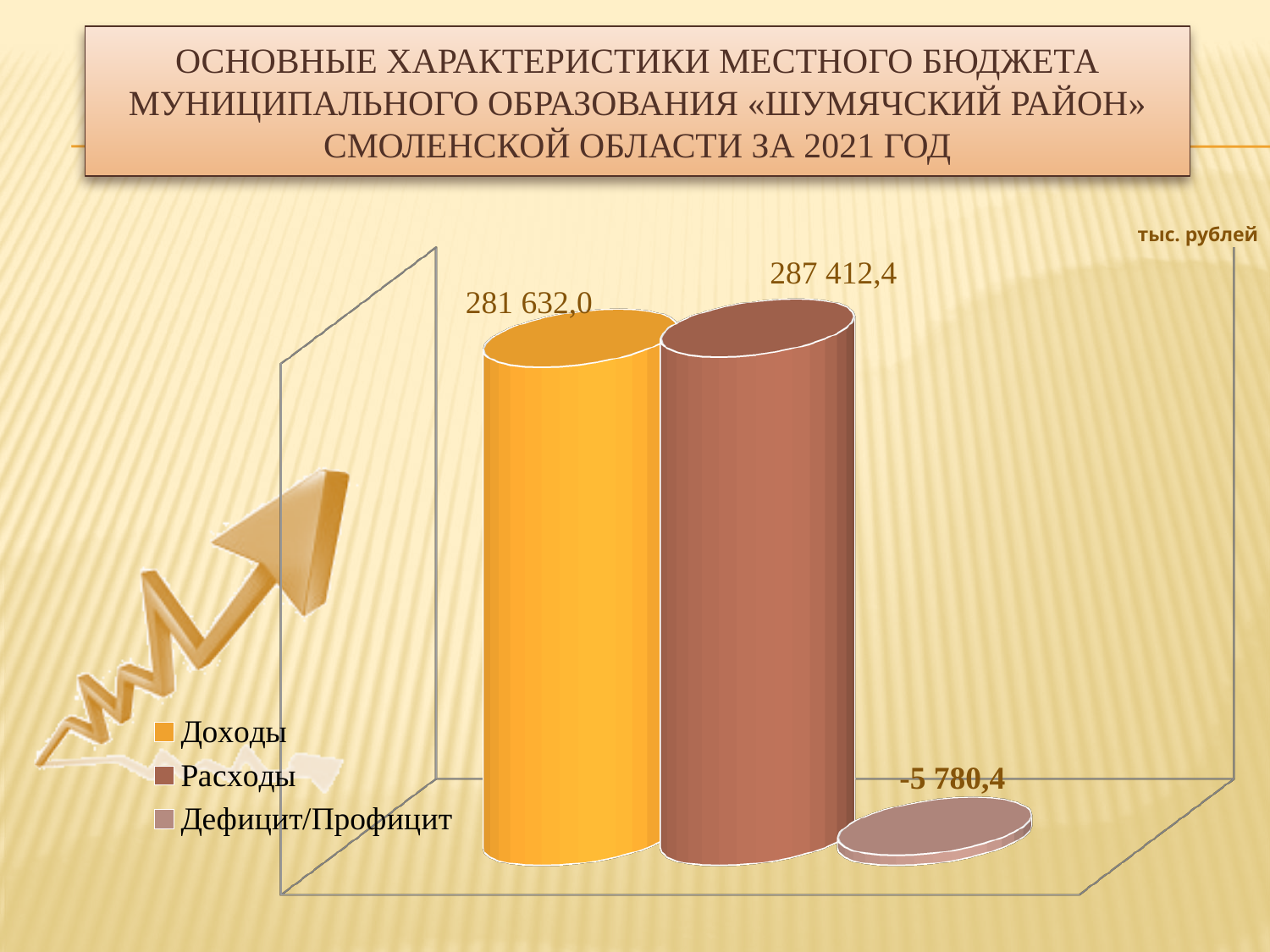
Which series has the highest value? Расходы What colour is the bar for Доходы? Orange/yellow What is the value for Расходы? 287 412,4 What kind of chart is shown on the slide? Bar chart Which series has the lowest value? Дефицит/Профицит What is the value for Доходы? 281 632,0 What is the difference between Расходы and Доходы? 5 780,4 What is the value for Дефицит/Профицит? -5 780,4 How many series does the legend list? 3 What unit of measurement is indicated for the chart values? тыс. рублей How many bars are plotted on the chart? 3 Which is larger, Доходы or Расходы? Расходы